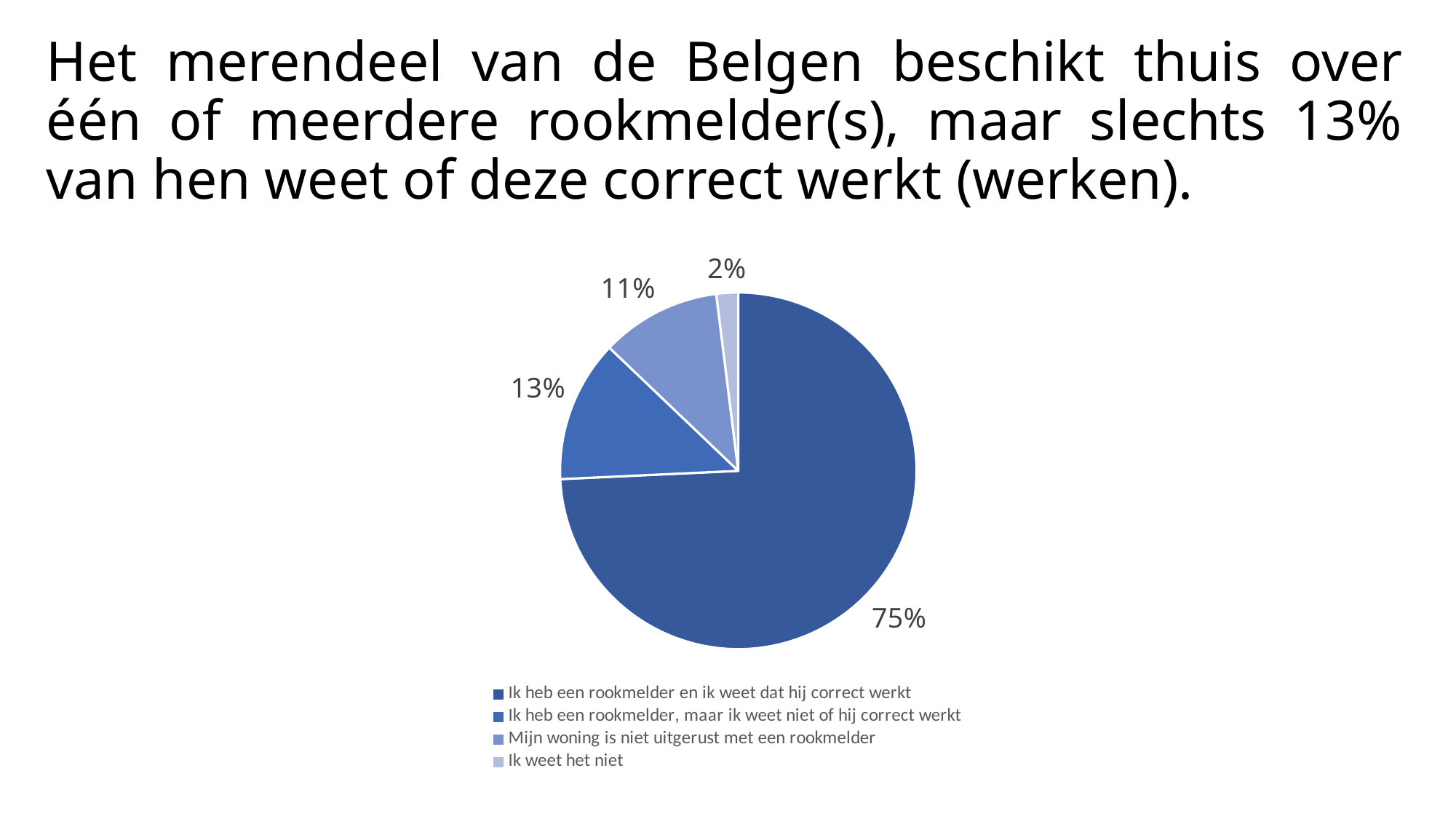
How many entries does the legend of the pie chart list? 4 What share of the pie is labelled 'Mijn woning is niet uitgerust met een rookmelder'? 11% Which category has the smallest slice of the pie? Ik weet het niet What share of the pie is labelled 'Ik weet het niet'? 2% How many slices does the pie chart have? 4 Which category has the largest slice of the pie? Ik heb een rookmelder en ik weet dat hij correct werkt What is the combined share of 'Mijn woning is niet uitgerust met een rookmelder' and 'Ik weet het niet'? 13% What is the difference between the share for 'Ik heb een rookmelder en ik weet dat hij correct werkt' and the share for 'Ik heb een rookmelder, maar ik weet niet of hij correct werkt'? 62% What share of the pie is labelled 'Ik heb een rookmelder en ik weet dat hij correct werkt'? 75% What kind of chart is shown on the slide? pie chart Which is larger: the share for 'Ik heb een rookmelder, maar ik weet niet of hij correct werkt' or the share for 'Mijn woning is niet uitgerust met een rookmelder'? Ik heb een rookmelder, maar ik weet niet of hij correct werkt